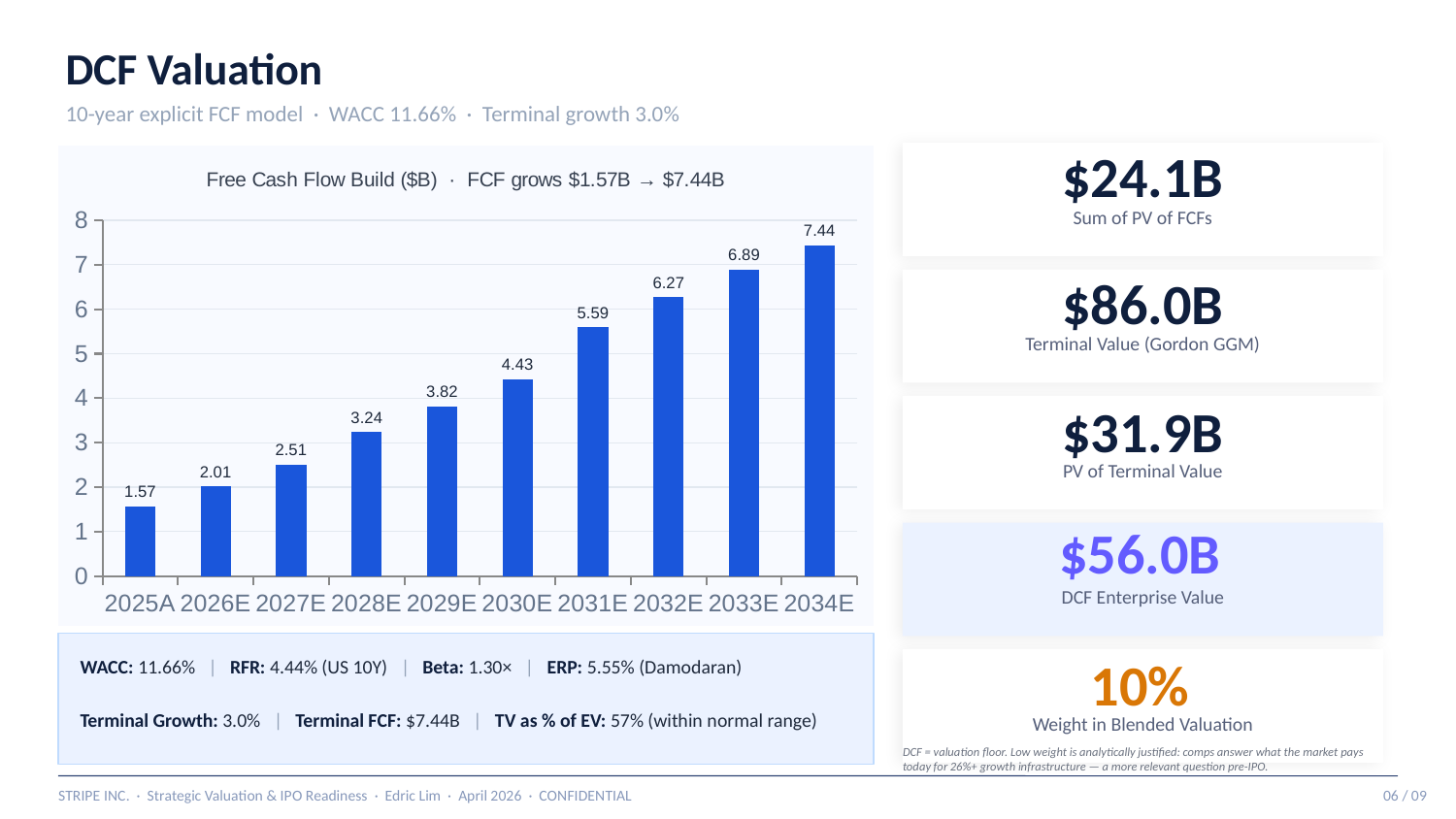
Which year has the highest free cash flow value? 2034E What kind of chart is used to show the free cash flow build? Bar chart How many years are shown on the x axis of the chart? 10 Which is larger, the free cash flow value for 2027E or for 2031E? 2031E What is the free cash flow value for 2029E? 3.82 Which year has the lowest free cash flow value? 2025A What is the free cash flow value for 2032E? 6.27 Do the free cash flow values rise or fall from 2025A to 2034E? Rise Is the free cash flow value for 2033E greater or less than 6? greater What is the free cash flow value for 2025A? 1.57 What is the difference between the free cash flow values for 2030E and 2028E? 1.19 What is the difference between the free cash flow values for 2034E and 2033E? 0.55